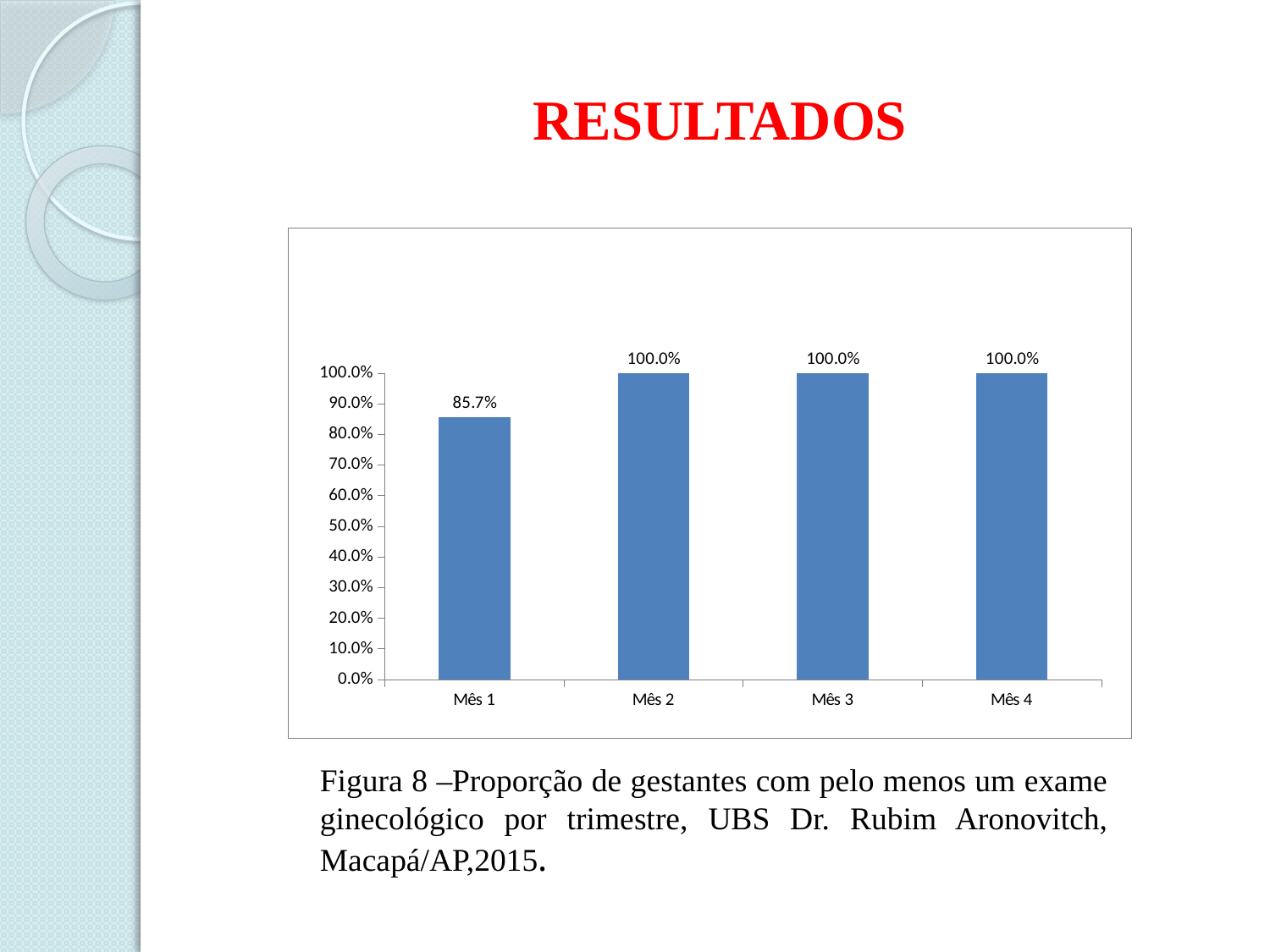
What kind of chart is shown on the slide? bar chart What is the value for Mês 1? 85.7% Which month has the lowest value? Mês 1 How many months are shown on the x axis? 4 What is the difference between the values for Mês 2 and Mês 1? 14.3% What is the value for Mês 4? 100.0% How many months have a value of 100.0%? 3 Which is larger, the value for Mês 1 or the value for Mês 3? Mês 3 What colour are the bars in the chart? blue Is the value for Mês 1 greater or less than 80.0%? greater Do the values rise or fall from Mês 1 to Mês 2? rise What is the value for Mês 2? 100.0%